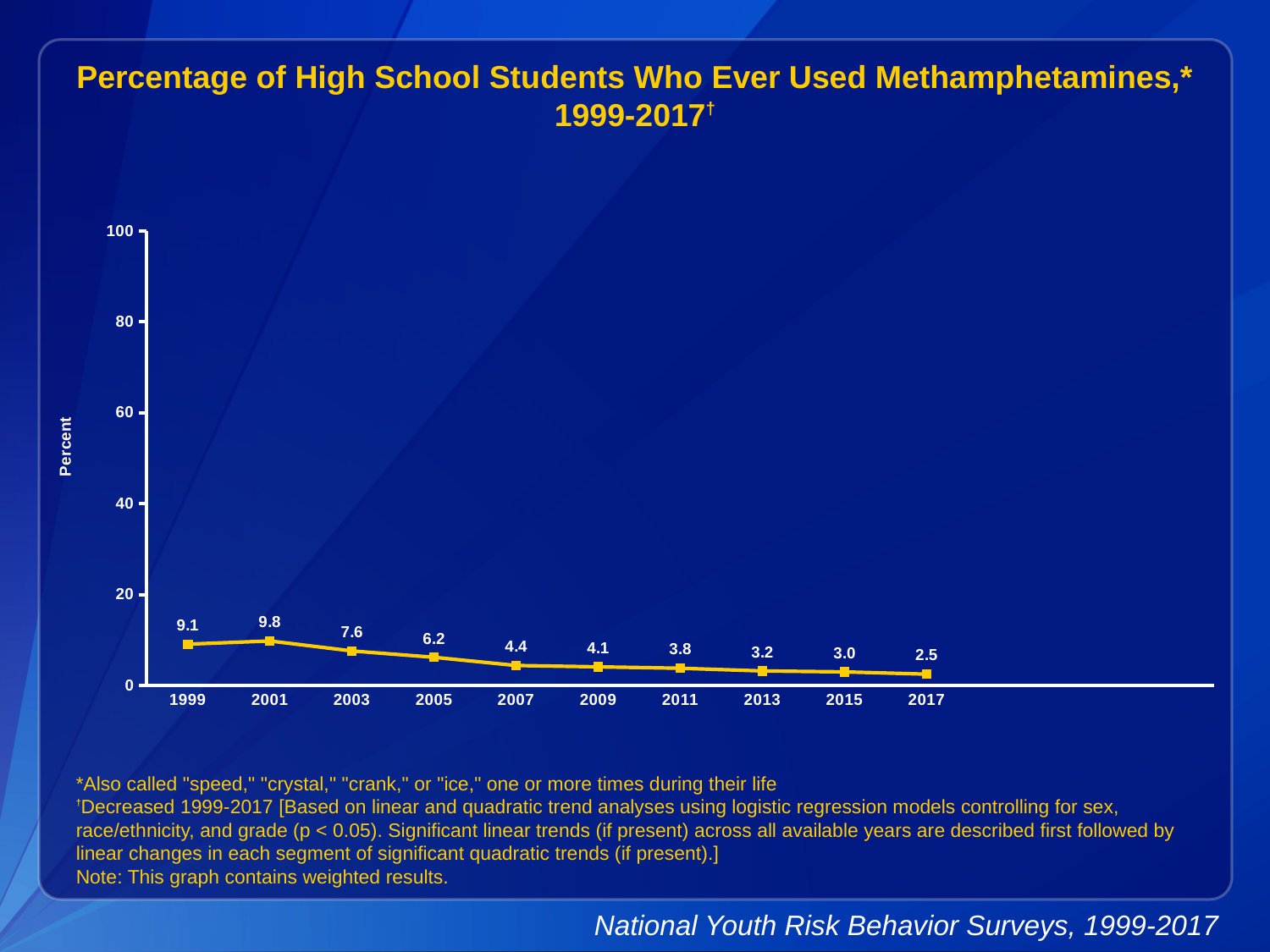
What is the difference between the 1999 value and the 2017 value? 6.6 What percentage of high school students had ever used methamphetamines in 1999? 9.1 Which year has the highest percentage? 2001 What is the value plotted for 2017? 2.5 Is the value for 2001 greater or less than 20? less How many years are plotted on the chart? 10 What is the difference between the 2001 value and the 2003 value? 2.2 Which year has the lowest percentage? 2017 What is the value plotted for 2009? 4.1 Which is larger, the value for 2005 or the value for 2011? 2005 Do the values generally rise or fall from 1999 to 2017? fall What kind of chart is shown on the slide? line chart